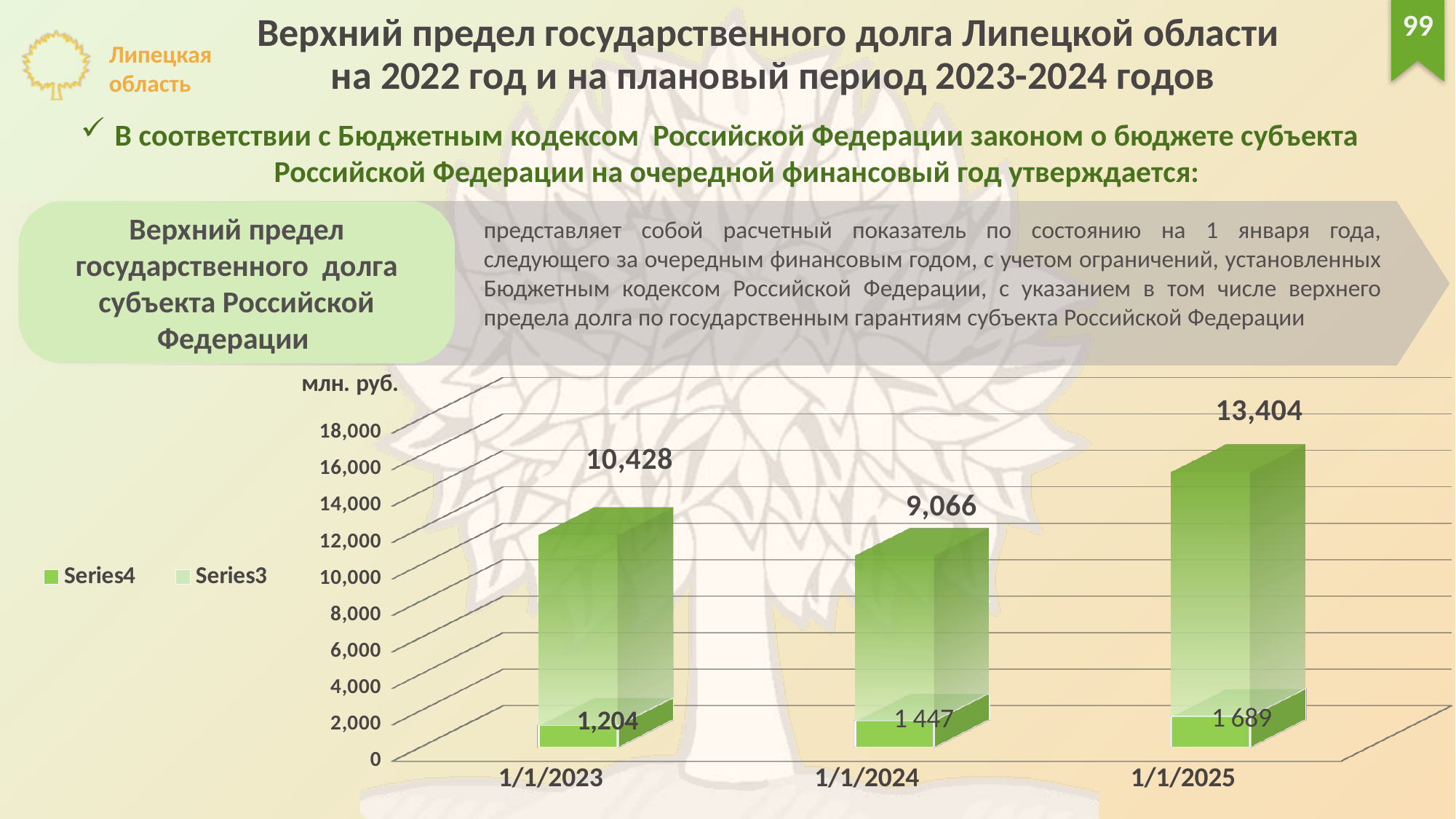
Which date has the lowest Series4 value? 1/1/2024 What is the Series4 value for 1/1/2025? 13,404 What is the difference between the Series4 values for 1/1/2025 and 1/1/2023? 2,976 What is the Series4 value for 1/1/2023? 10,428 How many series does the chart legend list? 2 Which is larger, the Series4 value for 1/1/2023 or for 1/1/2024? 1/1/2023 What kind of chart is shown on the slide? bar chart What is the Series3 value for 1/1/2024? 1 447 Which date has the highest Series4 value? 1/1/2025 How many dates are shown on the x axis of the chart? 3 What unit is shown above the vertical axis of the chart? млн. руб. What is the Series3 value for 1/1/2025? 1 689